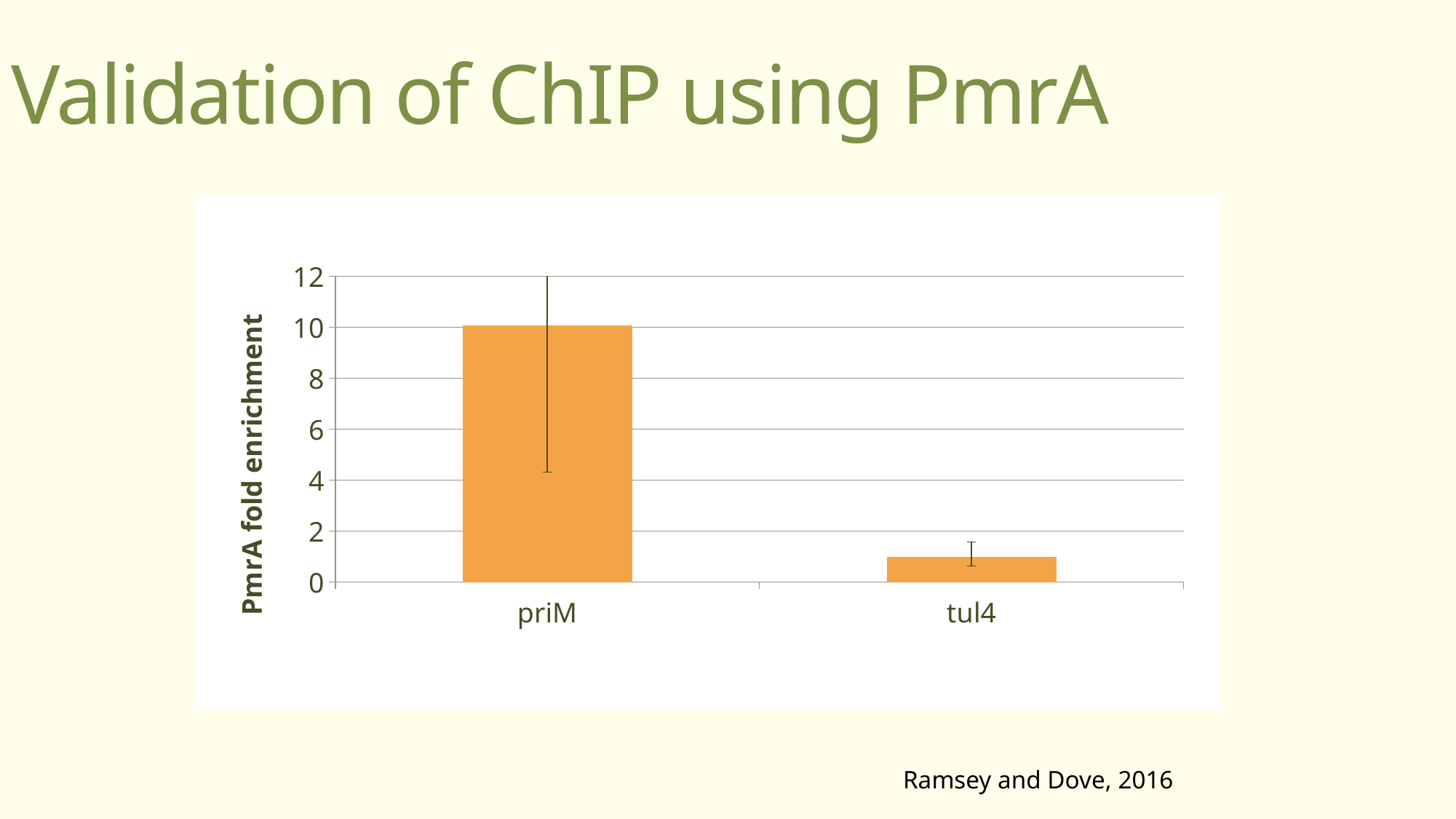
What kind of chart is shown on the slide? bar chart What colour are the bars in the chart? orange Which category has the highest PmrA fold enrichment? priM How many categories are plotted on the x axis? 2 What is the label of the y axis? PmrA fold enrichment Which has a larger PmrA fold enrichment, priM or tul4? priM Is the value for tul4 greater or less than 4? less Is the value for priM greater or less than 12? less Is the value for tul4 greater or less than 2? less Which category has the lowest PmrA fold enrichment? tul4